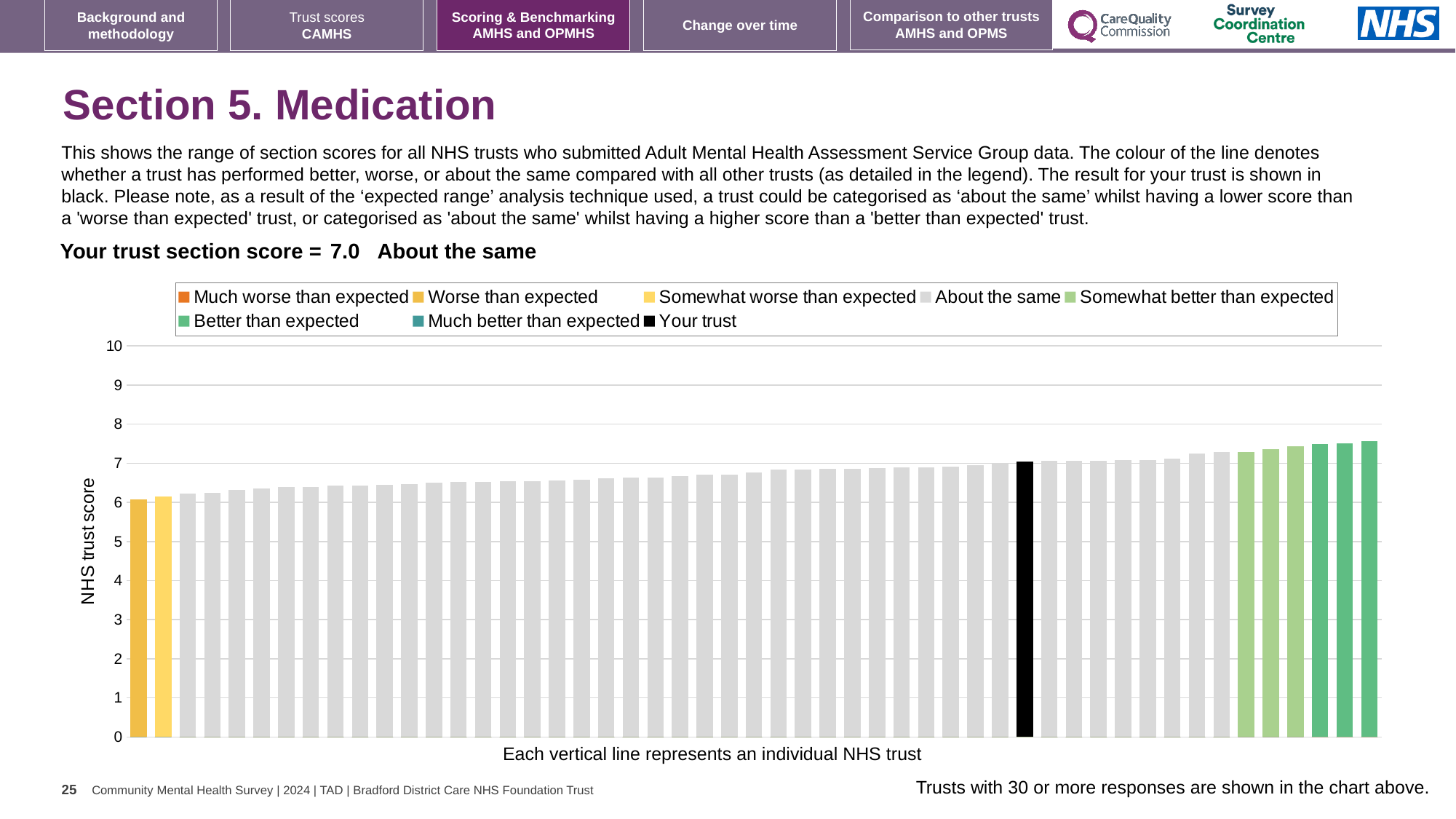
What is the section score for your trust shown on the slide? 7.0 What colour is the bar representing your trust? black How many entries does the chart legend list? 8 Is the value of the leftmost bar greater or less than 7? less What kind of chart is shown on the slide? bar chart Which is larger, the leftmost bar or the rightmost bar? the rightmost bar Do the bar values rise or fall from left to right along the x axis? rise Which category is your trust's section score placed in? About the same What is the label on the y axis of the chart? NHS trust score Is the value of the rightmost bar greater or less than 7? greater Which legend category does the tallest bar belong to? Better than expected Is the value of the black 'Your trust' bar greater or less than 6? greater